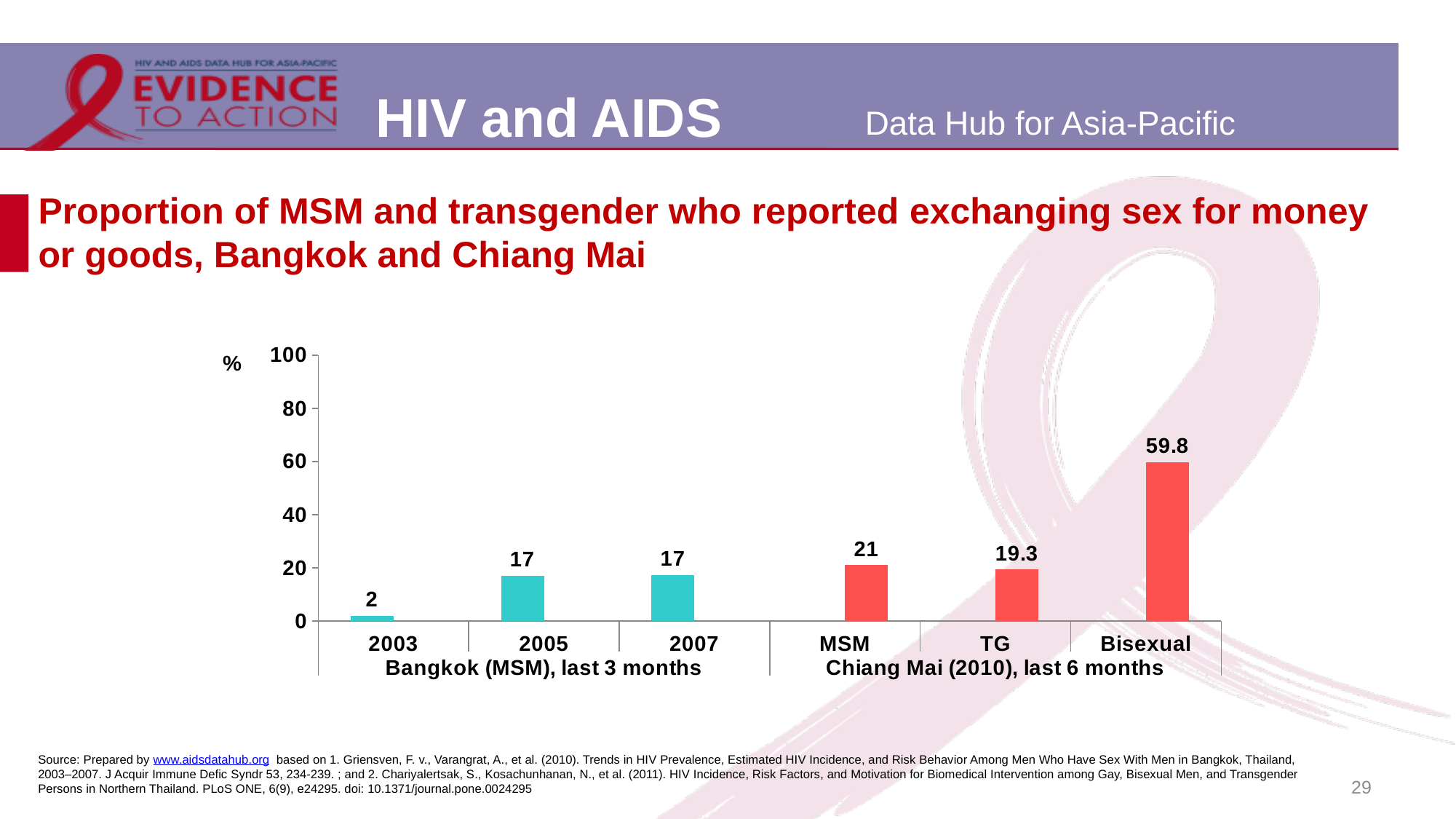
How many bars are plotted in the chart? 6 Which is larger, the value for MSM or for TG in Chiang Mai (2010)? MSM What is the value for TG in Chiang Mai (2010)? 19.3 What is the value for Bangkok MSM in 2007? 17 Is the value for Bisexual greater or less than 40? greater Which category has the highest value? Bisexual What is the value for Bangkok MSM in 2003? 2 What is the difference between the Bangkok MSM values for 2005 and 2003? 15 Which category has the lowest value? 2003 What kind of chart is shown on the slide? Bar chart What is the difference between the Bisexual value and the MSM value for Chiang Mai (2010)? 38.8 What is the value for Bisexual in Chiang Mai (2010)? 59.8